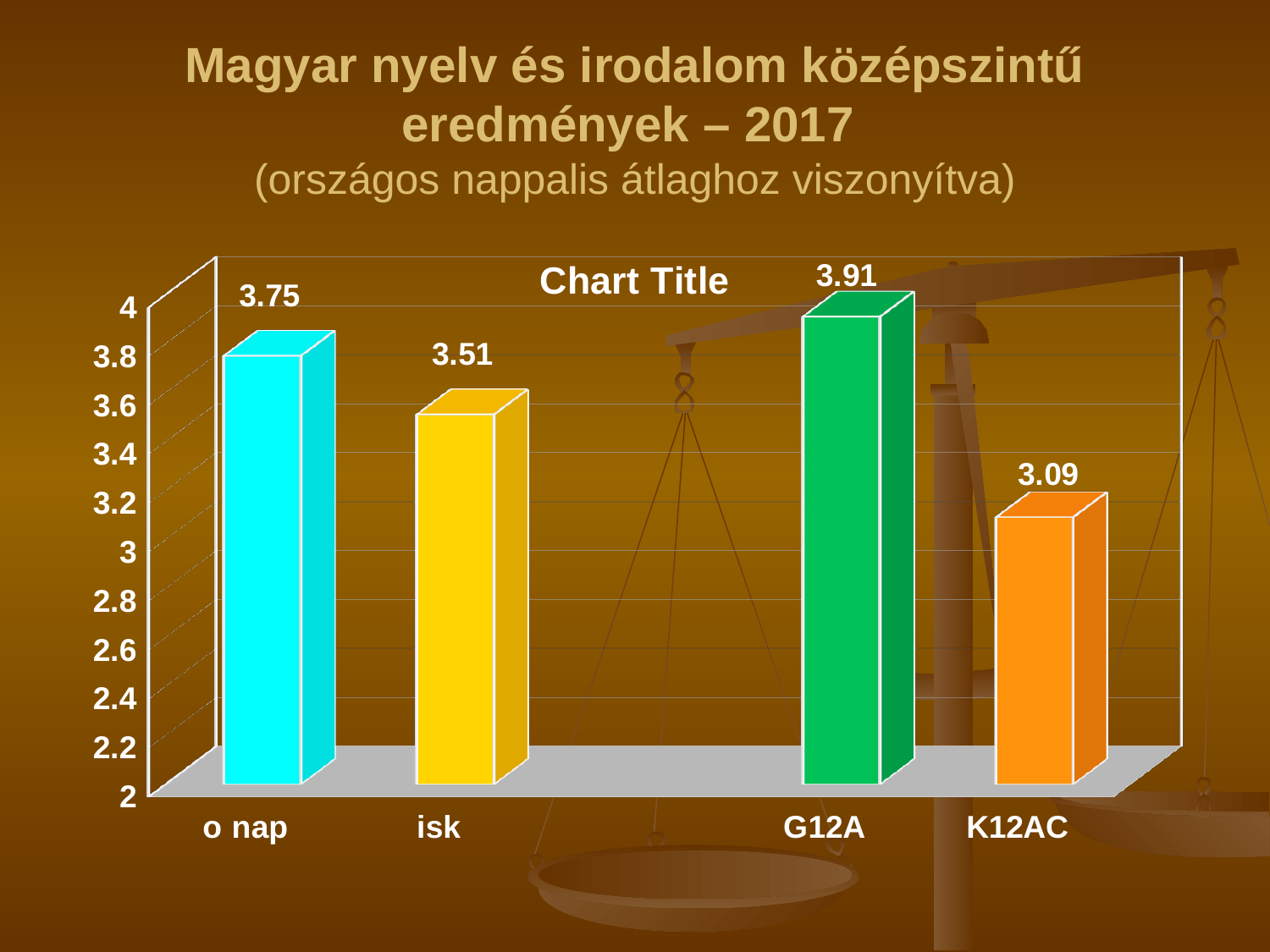
What is the value for isk? 3.51 What is the difference between the values for o nap and isk? 0.24 Which category has the highest value? G12A What is the value for G12A? 3.91 Which category has the lowest value? K12AC What kind of chart is shown on the slide? bar chart What is the value for K12AC? 3.09 What is the difference between the values for G12A and K12AC? 0.82 What is the value for o nap? 3.75 Is the value for K12AC greater or less than 3.2? less How many categories are shown in the chart? 4 Which is larger, the value for o nap or the value for isk? o nap